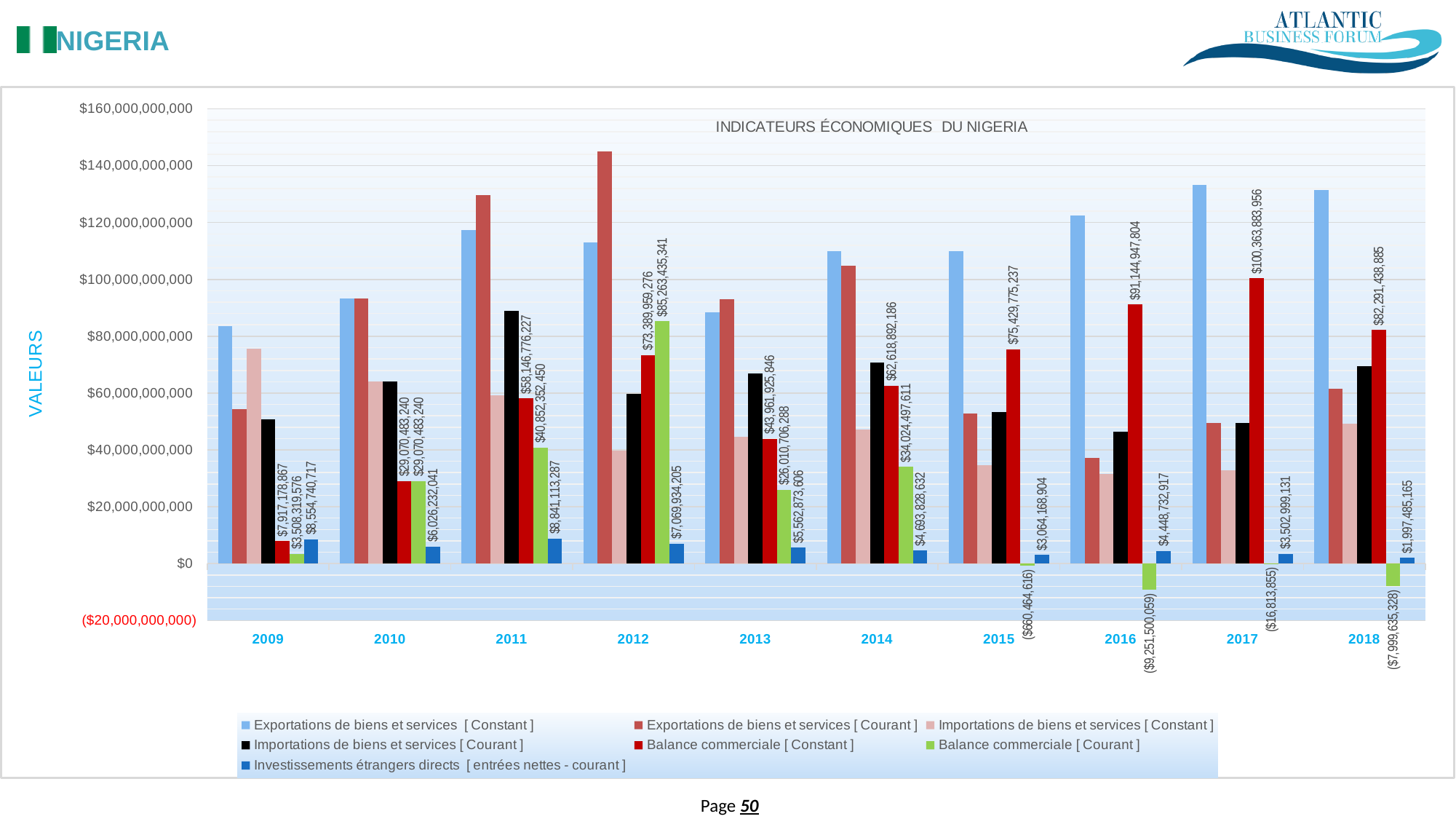
What kind of chart is shown on the slide? bar chart What is the difference between Balance commerciale [Constant] in 2016 and in 2015? $15,715,172,567 Is the value of Exportations de biens et services [Courant] in 2012 greater or less than $140,000,000,000? greater What is the value of Balance commerciale [Constant] in 2017? $100,363,883,956 In which year is Investissements étrangers directs [entrées nettes - courant] the lowest? 2018 What is the value of Balance commerciale [Courant] in 2016? ($9,251,500,059) What is the value of Investissements étrangers directs [entrées nettes - courant] in 2009? $8,554,740,717 In 2012, which is larger: Balance commerciale [Constant] or Balance commerciale [Courant]? Balance commerciale [Courant] What is the title of the chart? INDICATEURS ÉCONOMIQUES DU NIGERIA In which year is Balance commerciale [Constant] the highest? 2017 How many series does the legend list? 7 How many years are shown on the x axis of the chart? 10